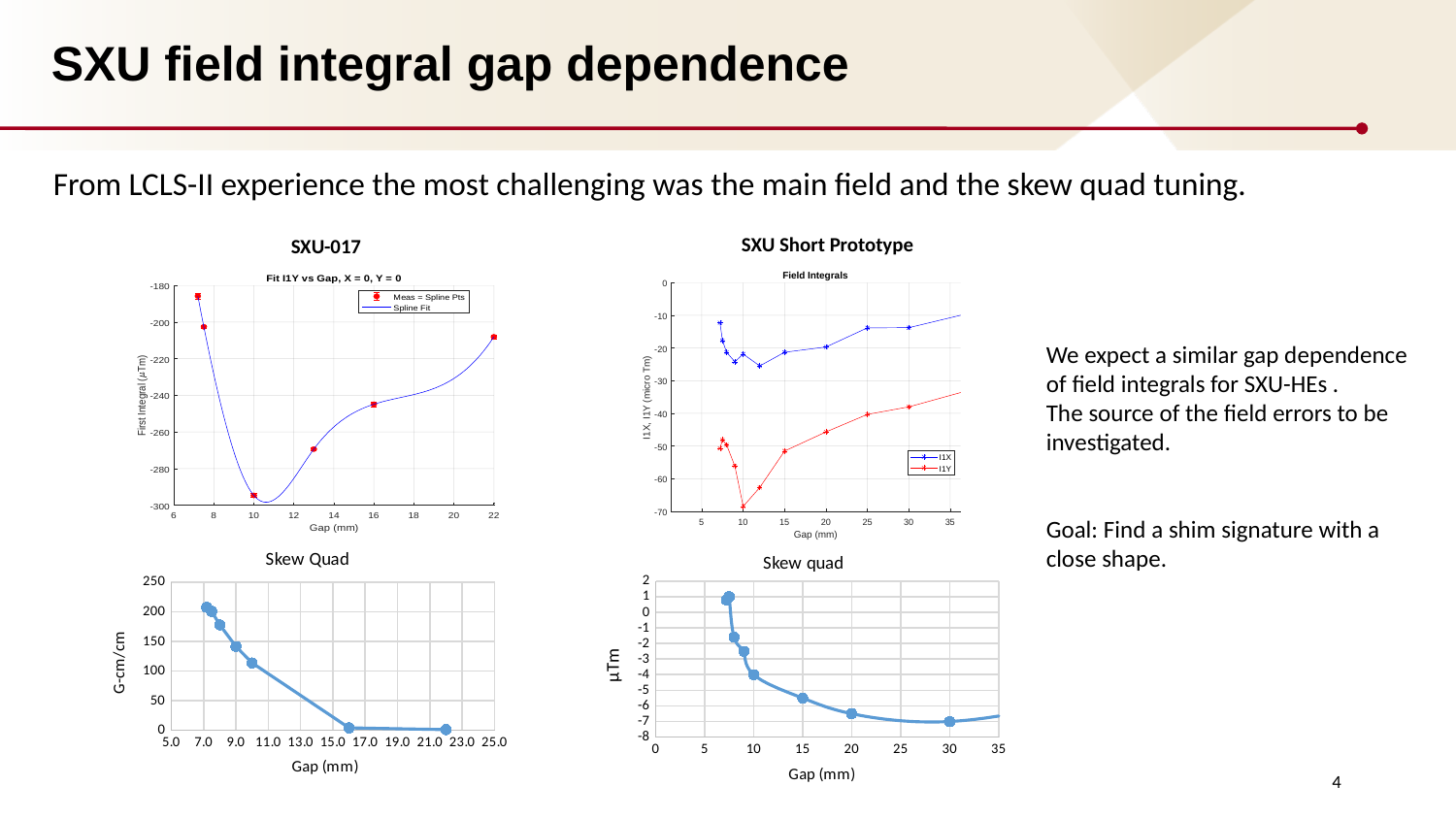
In the bottom-left chart titled 'Skew Quad', is the value at a gap of 7.0 mm greater or less than 150? greater In the top-left chart titled 'Fit I1Y vs Gap, X = 0, Y = 0', how many series does the legend list? 2 In the top-right chart titled 'Field Integrals', do the I1X values rise or fall as the gap increases from 15 mm to 35 mm? rise In the bottom-right chart titled 'Skew quad', is the value at a gap of 30 mm greater or less than -6? less In the bottom-left chart titled 'Skew Quad', do the values rise or fall as the gap increases? fall In the top-left chart titled 'Fit I1Y vs Gap, X = 0, Y = 0', is the first integral at a gap of 10 mm greater or less than -280? less In the top-right chart titled 'Field Integrals', what are the two series named in the legend? I1X and I1Y In the bottom-left chart titled 'Skew Quad', what is the y-axis label? G-cm/cm What kind of chart is the bottom-right chart titled 'Skew quad'? line chart